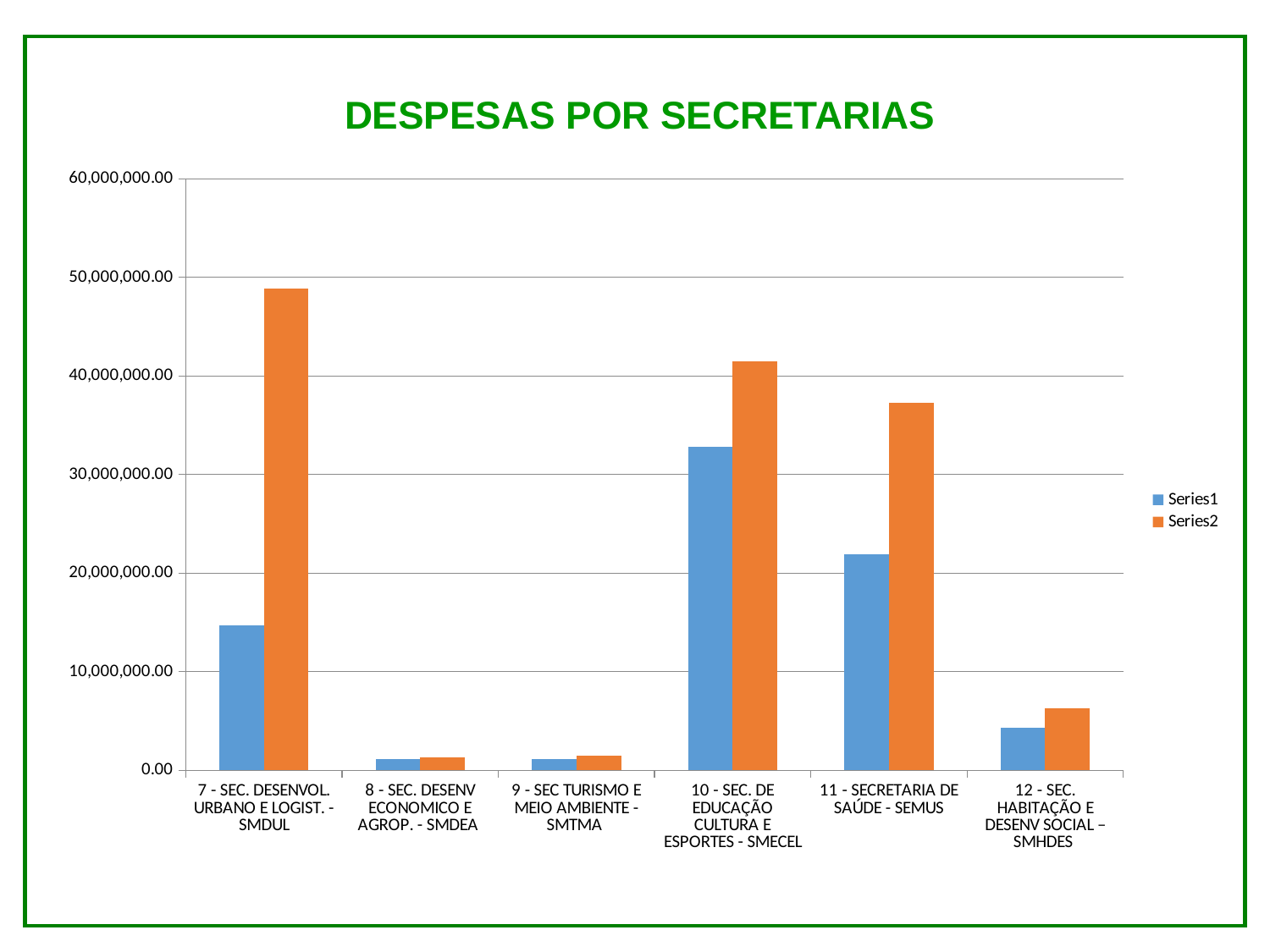
How many series does the legend list? 2 What kind of chart is shown on the slide? bar chart Is the Series2 value for 7 - SEC. DESENVOL. URBANO E LOGIST. - SMDUL greater or less than 40,000,000.00? greater What is the title of the chart? DESPESAS POR SECRETARIAS Which category has the highest Series1 value? 10 - SEC. DE EDUCAÇÃO CULTURA E ESPORTES - SMECEL Is the Series1 value for 11 - SECRETARIA DE SAÚDE - SEMUS greater or less than 30,000,000.00? less How many secretarias (categories) are shown on the x axis? 6 Which category has the highest Series2 value? 7 - SEC. DESENVOL. URBANO E LOGIST. - SMDUL Which is larger, the Series2 value for 10 - SEC. DE EDUCAÇÃO CULTURA E ESPORTES - SMECEL or the Series2 value for 11 - SECRETARIA DE SAÚDE - SEMUS? 10 - SEC. DE EDUCAÇÃO CULTURA E ESPORTES - SMECEL Is the Series1 value for 10 - SEC. DE EDUCAÇÃO CULTURA E ESPORTES - SMECEL greater or less than 30,000,000.00? greater For 11 - SECRETARIA DE SAÚDE - SEMUS, which is larger, Series1 or Series2? Series2